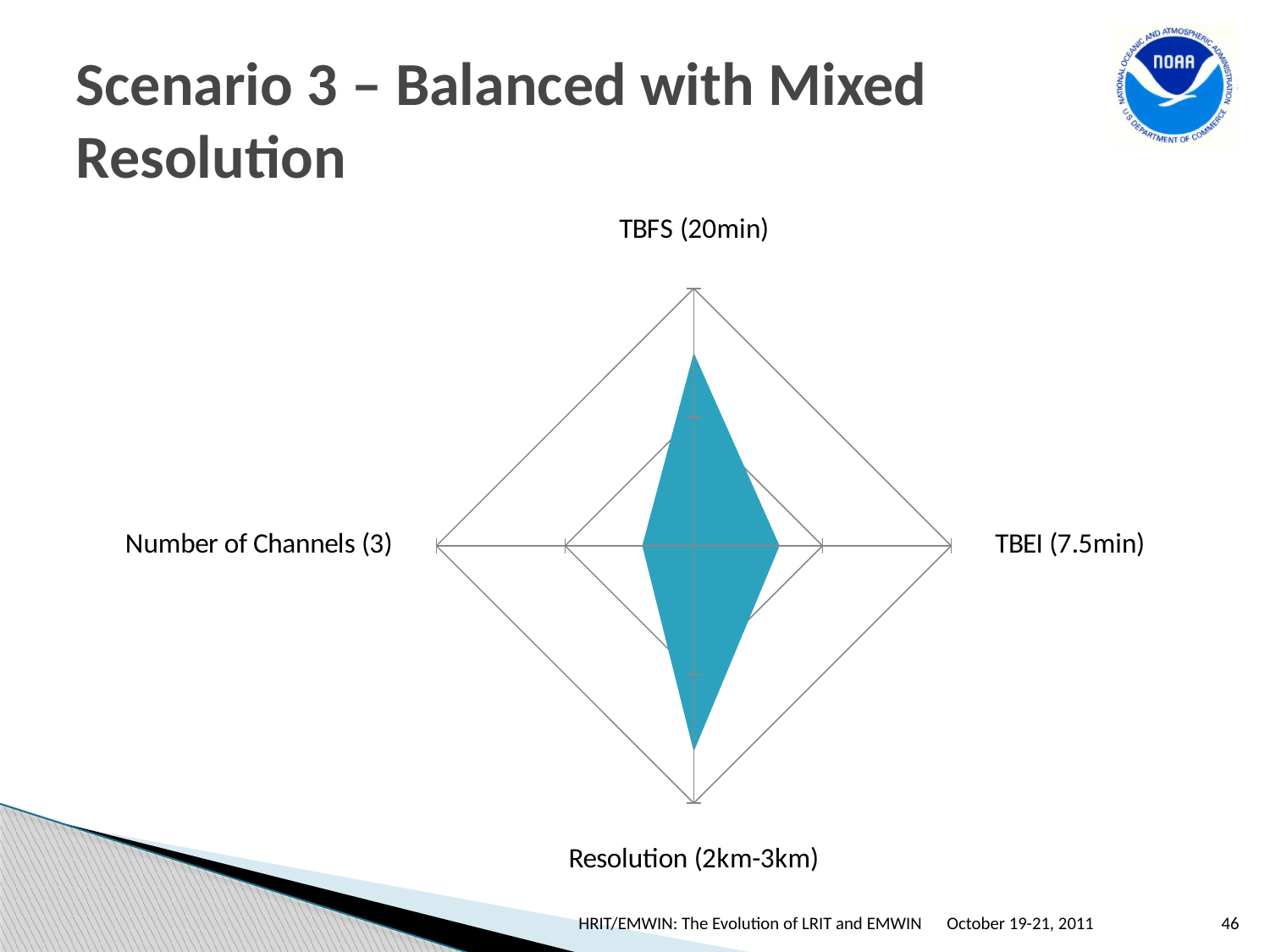
Which extends further from the centre of the radar chart: the Resolution (2km-3km) axis or the TBEI (7.5min) axis? Resolution (2km-3km) What is the title of the slide containing the radar chart? Scenario 3 – Balanced with Mixed Resolution Which extends further from the centre of the radar chart: the TBFS (20min) axis or the Number of Channels (3) axis? TBFS (20min) Which axis label appears at the bottom of the radar chart? Resolution (2km-3km) What kind of chart is shown on the slide? Radar chart How many axes (categories) does the radar chart have? 4 Which extends further from the centre of the radar chart: the TBFS (20min) axis or the TBEI (7.5min) axis? TBFS (20min) How many data series are plotted on the radar chart? 1